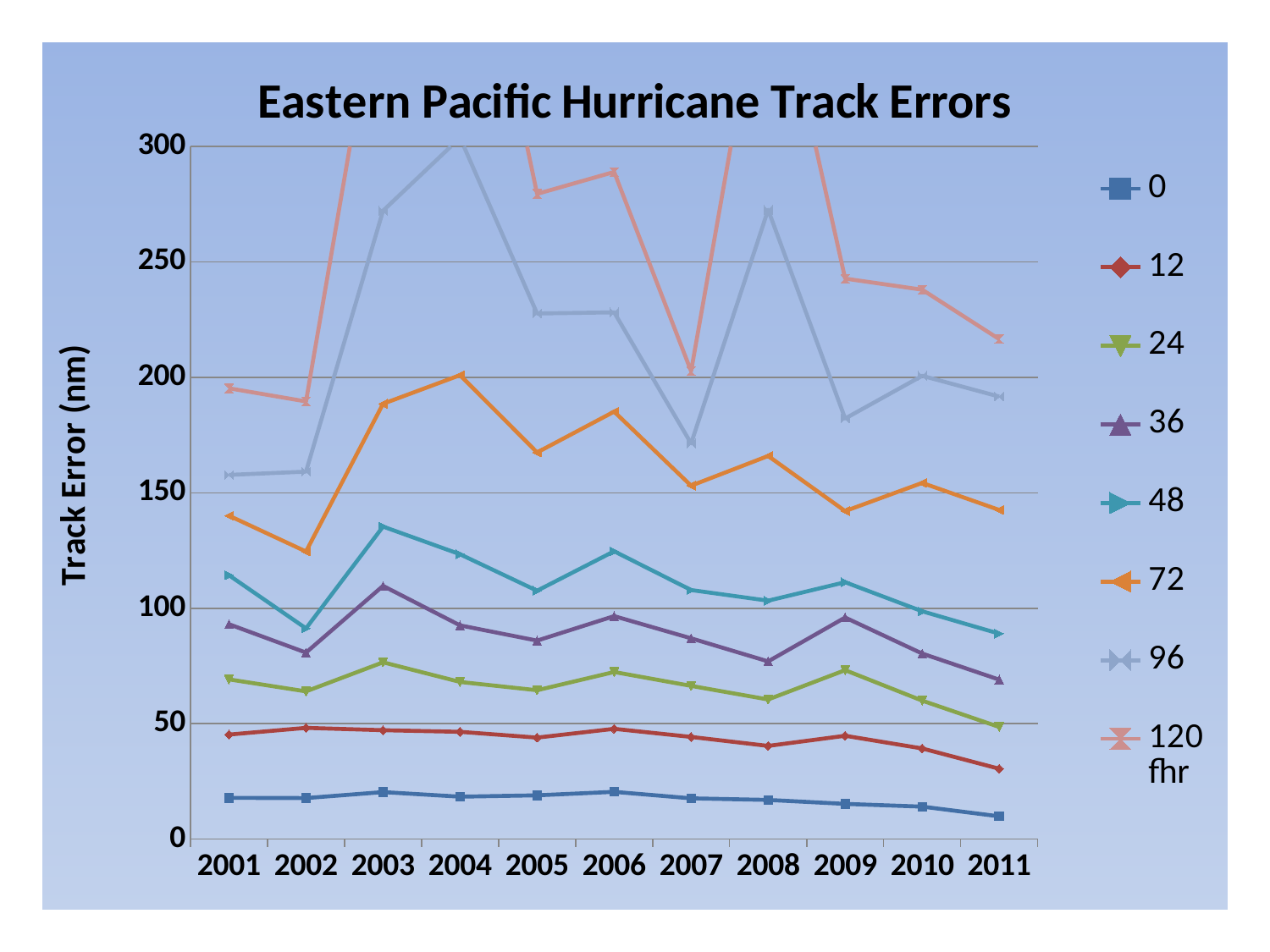
How many series does the legend list? 8 Is the value for the 48 series in 2003 greater or less than 100? greater How many years are plotted along the x axis? 11 In which year is the 0 series at its lowest value? 2011 Which series has the highest track errors across the years? 120 fhr What is the title of the chart? Eastern Pacific Hurricane Track Errors What is the label of the vertical axis? Track Error (nm) What kind of chart is shown on the slide? line chart Is the value for the 120 fhr series in 2011 greater or less than 200? greater Is the value for the 12 series in 2011 greater or less than 50? less For the 48 series, which is larger: the value in 2003 or the value in 2011? 2003